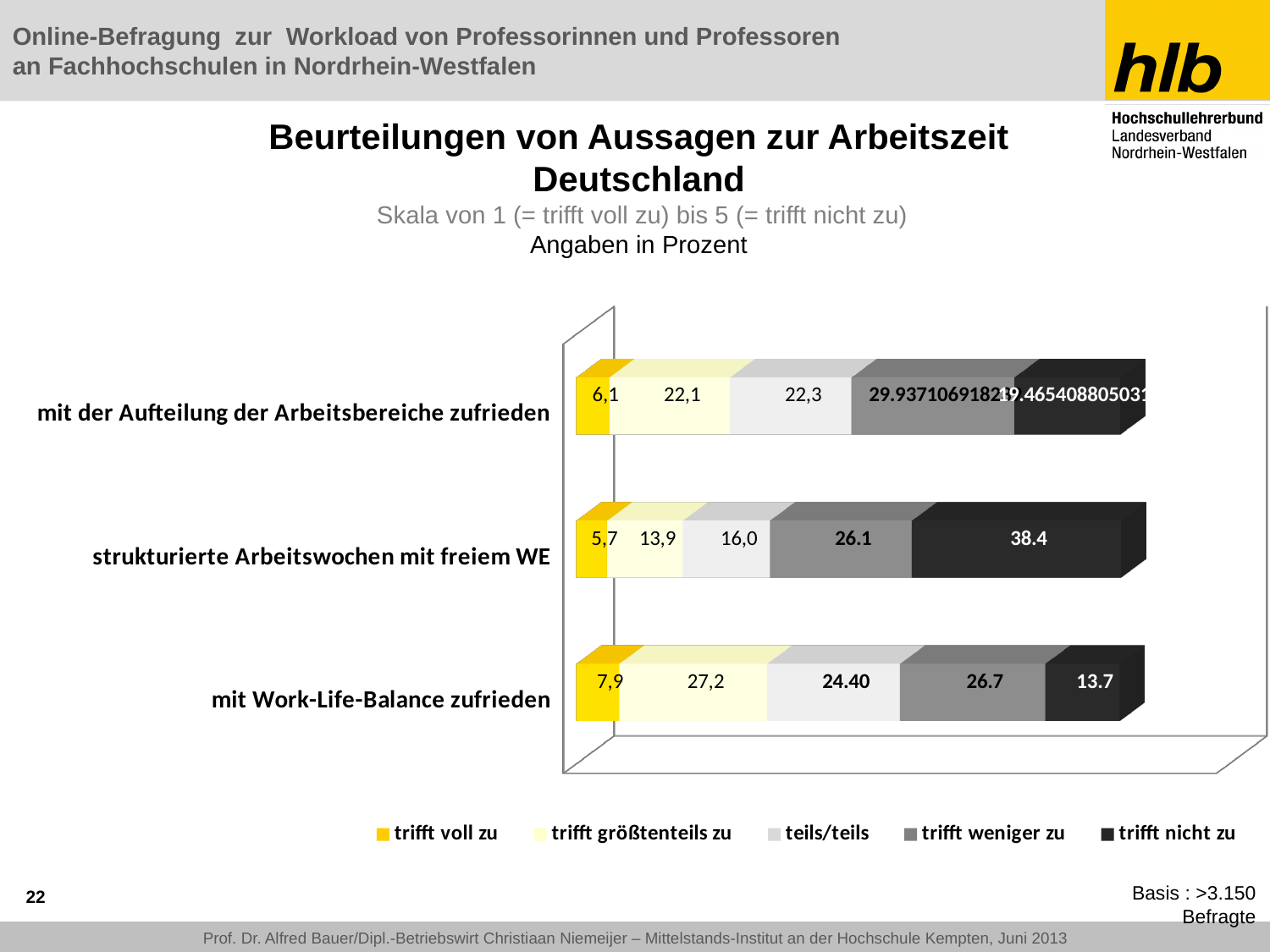
How many categories are shown in the chart? 3 How many series does the legend list? 5 What is the value for "trifft voll zu" in the category "mit Work-Life-Balance zufrieden"? 7,9 What is the value for "trifft größtenteils zu" in the category "mit Work-Life-Balance zufrieden"? 27,2 Which category has the highest value for "trifft voll zu"? mit Work-Life-Balance zufrieden What is the difference between the "trifft nicht zu" values for "strukturierte Arbeitswochen mit freiem WE" and "mit Work-Life-Balance zufrieden"? 24.7 Which is larger: the "teils/teils" value for "mit der Aufteilung der Arbeitsbereiche zufrieden" or for "strukturierte Arbeitswochen mit freiem WE"? mit der Aufteilung der Arbeitsbereiche zufrieden What is the difference between the "trifft größtenteils zu" values for "mit Work-Life-Balance zufrieden" and "strukturierte Arbeitswochen mit freiem WE"? 13,3 What is the value for "trifft nicht zu" in the category "strukturierte Arbeitswochen mit freiem WE"? 38.4 Which category has the lowest value for "trifft größtenteils zu"? strukturierte Arbeitswochen mit freiem WE What is the value for "teils/teils" in the category "mit der Aufteilung der Arbeitsbereiche zufrieden"? 22,3 What kind of chart is shown on the slide? Stacked bar chart